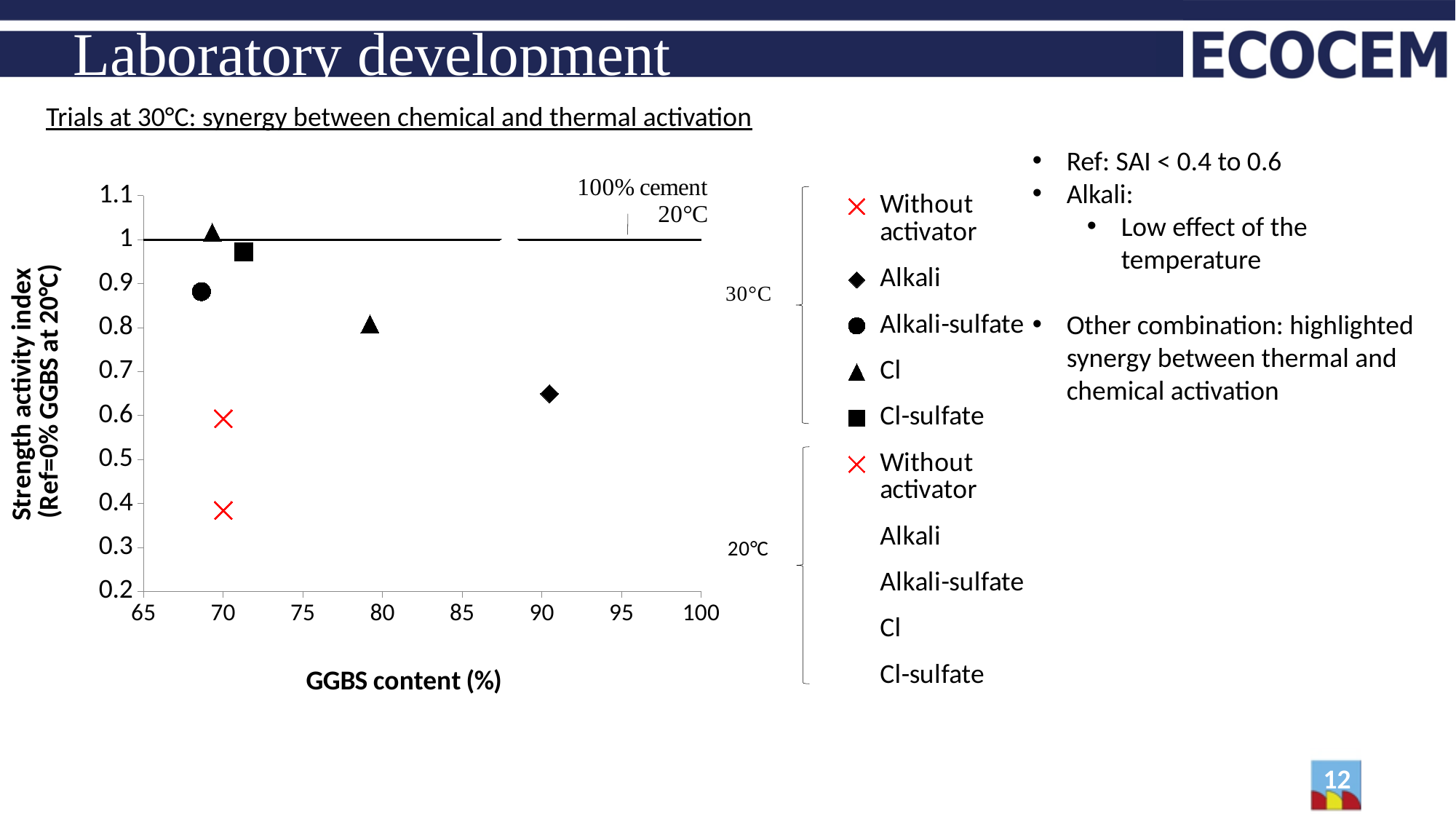
Is the higher of the two Without activator points greater or less than 0.5? greater Which series has the highest plotted strength activity index? Cl At what strength activity index value is the horizontal reference line labelled 100% cement 20°C drawn? 1 Is the strength activity index for the Alkali point greater or less than 0.7? less Which series has the lowest plotted strength activity index? Without activator What kind of chart is shown on the slide? scatter chart What is the title of the x axis of the chart? GGBS content (%) Is the strength activity index for the Cl-sulfate point greater or less than 0.9? greater How many series are listed in the 30°C group of the legend? 5 Which has a higher strength activity index, the Alkali-sulfate point or the Alkali point? Alkali-sulfate How many Cl (triangle) points are plotted on the chart? 2